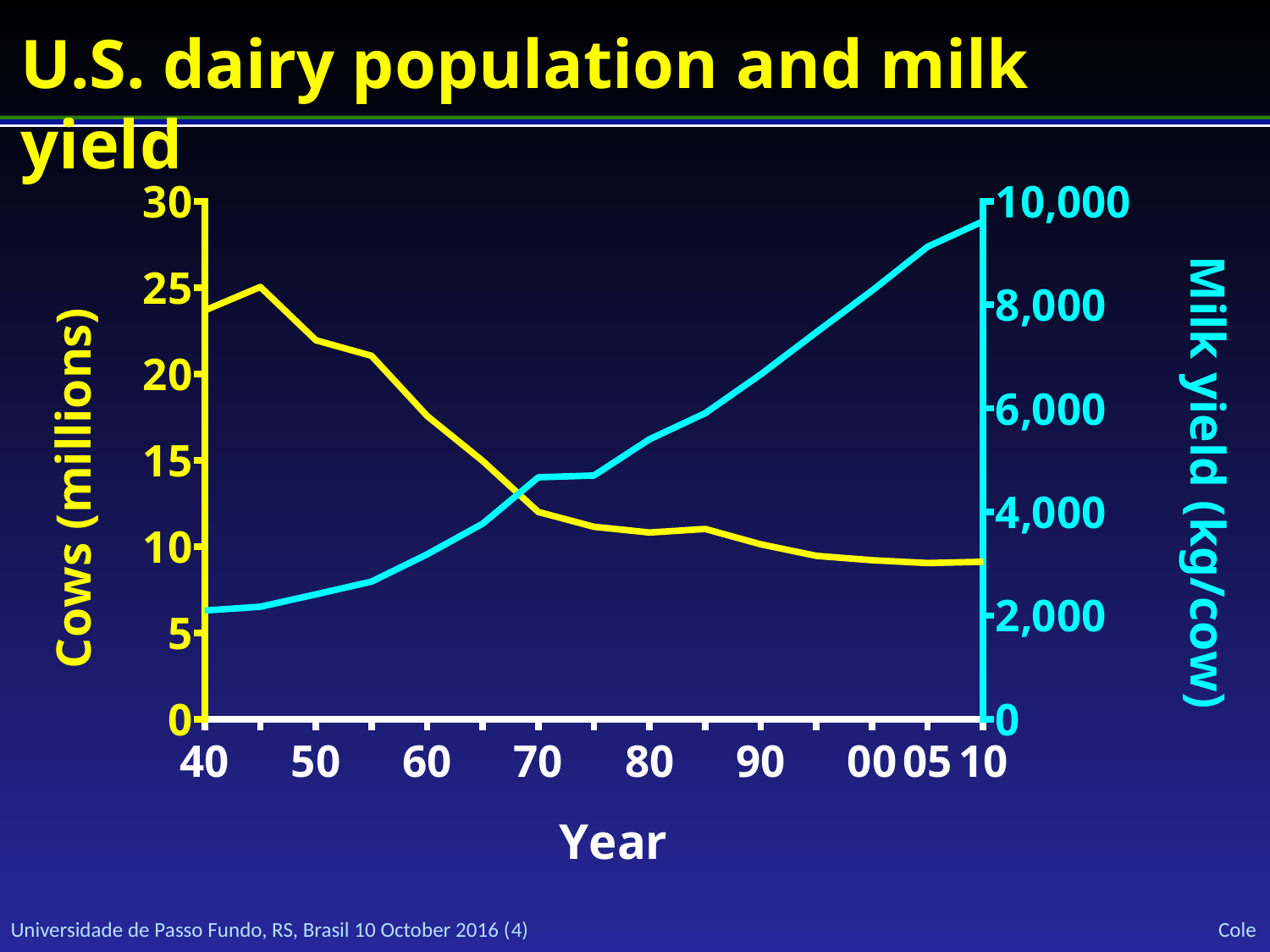
Is the value of Cows (millions) in year 40 greater or less than 20? greater What is the label of the right-hand vertical axis? Milk yield (kg/cow) Is the Milk yield (kg/cow) in year 60 greater or less than 4,000? less Is the value of Cows (millions) in year 70 greater or less than 15? less What is the title of the chart on the slide? U.S. dairy population and milk yield Which year has the larger value of Cows (millions), 50 or 80? 50 In which year is the Milk yield (kg/cow) line at its highest? 10 Does the Milk yield (kg/cow) line rise or fall across the years shown? rise Does the Cows (millions) line generally rise or fall from 1950 to 2010? fall In which year is the Milk yield (kg/cow) line at its lowest? 40 What kind of chart is shown on the slide? line chart